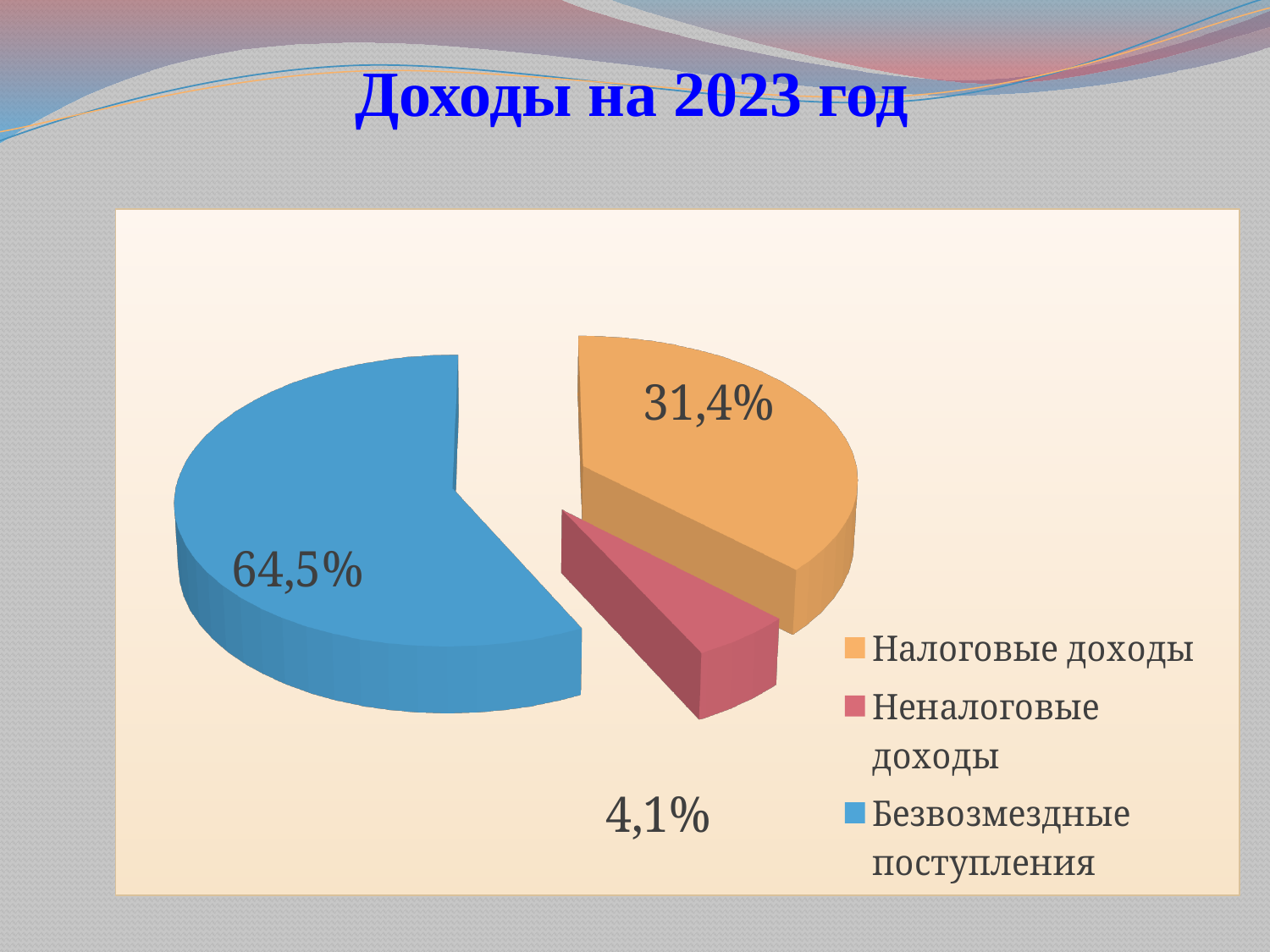
What is the combined share of Налоговые доходы and Неналоговые доходы? 35,5% What share of the pie is labelled for Безвозмездные поступления? 64,5% What is the difference in percentage points between Безвозмездные поступления and Налоговые доходы? 33,1 What is the title of the slide? Доходы на 2023 год How many categories does the pie chart show? 3 What kind of chart is shown on the slide? Pie chart What share of the pie is labelled for Неналоговые доходы? 4,1% What colour is the slice for Безвозмездные поступления? Blue Which category has the largest slice of the pie? Безвозмездные поступления Which category has the smallest slice of the pie? Неналоговые доходы What share of the pie is labelled for Налоговые доходы? 31,4% Which is larger, the slice for Налоговые доходы or the slice for Неналоговые доходы? Налоговые доходы